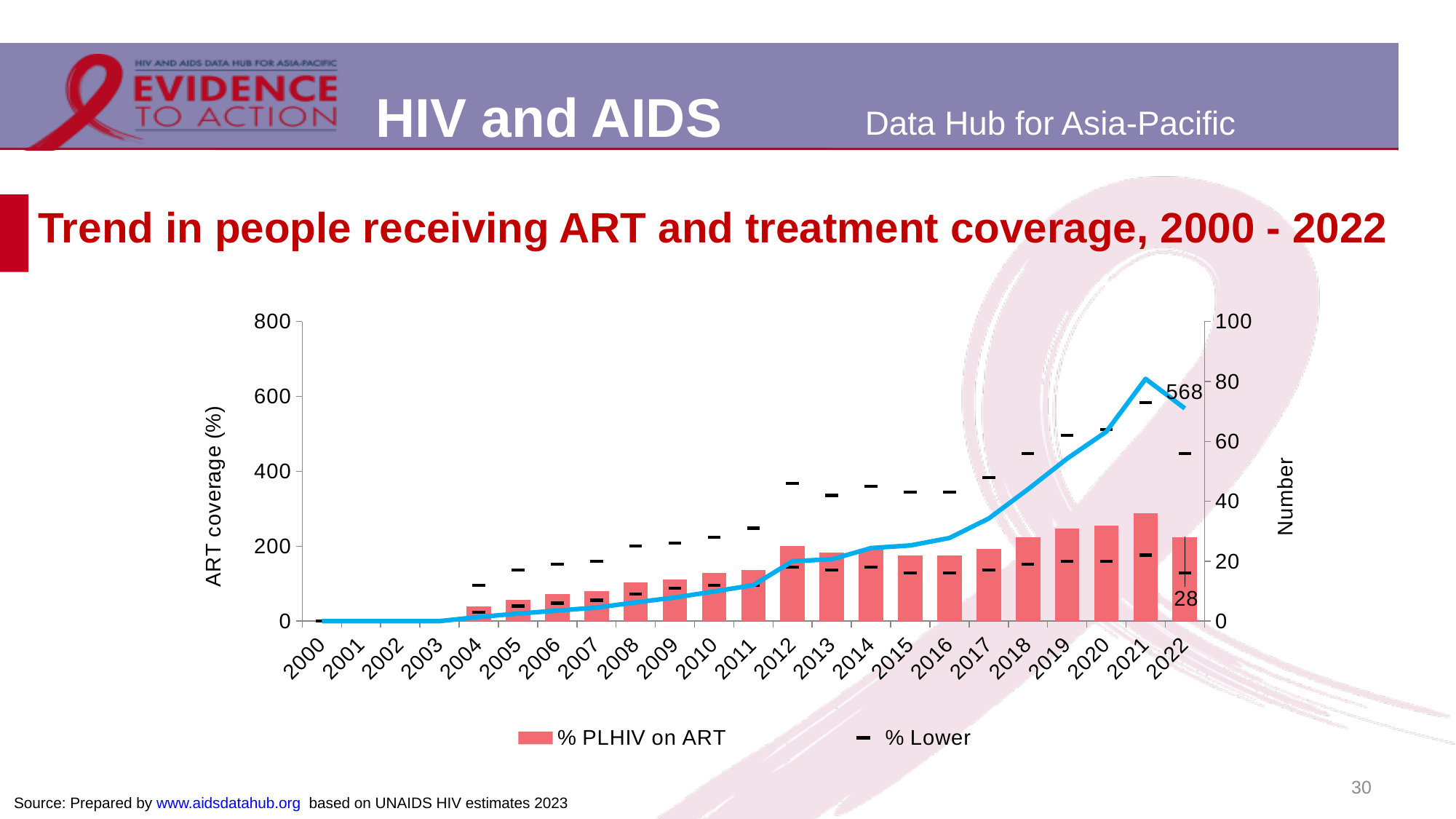
What is the title of the left-hand vertical axis? ART coverage (%) How many years are shown along the x axis of the chart? 23 What data label is printed on the bar for 2022? 28 Does the blue line generally rise or fall from 2000 to 2021? Rise Which year has the tallest bar in the chart? 2021 What kind of chart is shown on the slide? A combined bar and line chart In which year does the first visible bar appear? 2004 What are the two entries in the chart legend? % PLHIV on ART and % Lower Which is taller, the bar for 2021 or the bar for 2022? 2021 Which is taller, the bar for 2015 or the bar for 2018? 2018 How many series does the chart legend list? 2